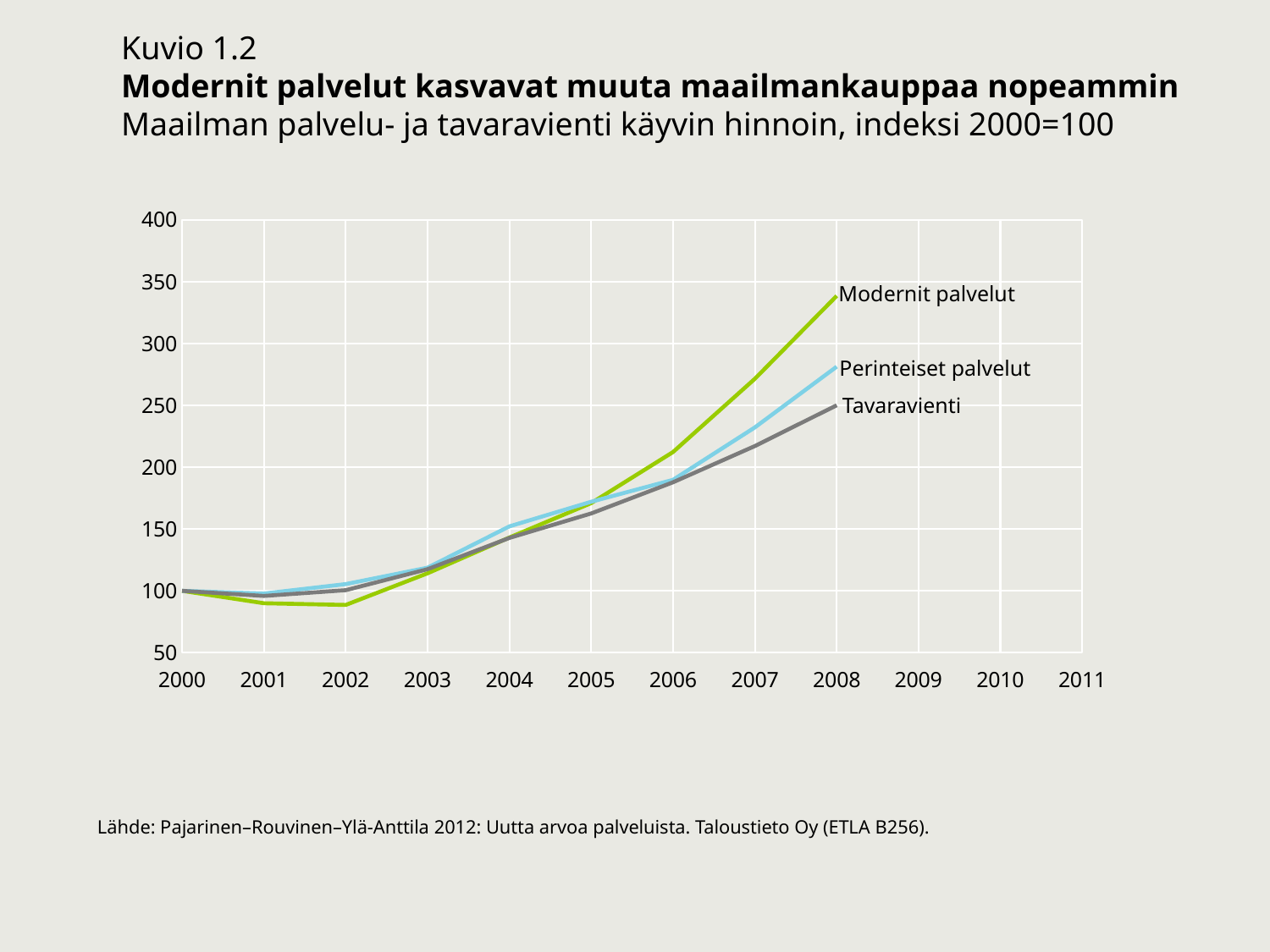
What kind of chart is shown on the slide? line chart Does the Tavaravienti series rise or fall from 2002 to 2008? rise In 2002, which is larger: Perinteiset palvelut or Modernit palvelut? Perinteiset palvelut Is the value for Modernit palvelut in 2002 greater or less than 100? less How many series are plotted in the chart? 3 Is the value for Tavaravienti in 2008 greater or less than 200? greater How many years are labelled on the x axis? 12 Which series has the highest value in 2008? Modernit palvelut Is the value for Modernit palvelut in 2008 greater or less than 300? greater What is the index value of all three series in 2000? 100 Which series has the lowest value in 2008? Tavaravienti